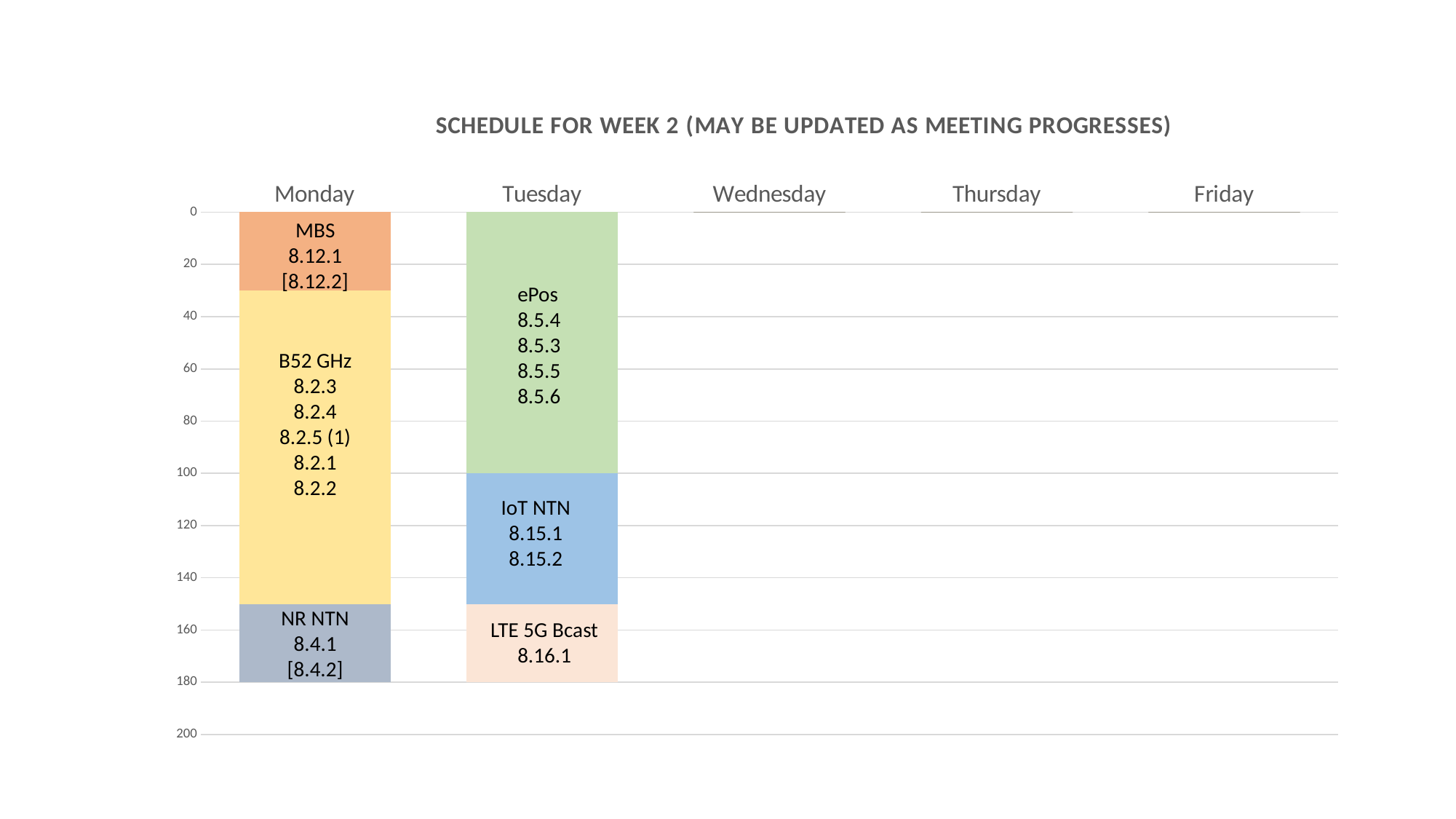
How many day categories are shown along the x axis? 5 How many segments make up the Monday bar? 3 Which segment is the largest in the Monday bar? B52 GHz How many segments make up the Tuesday bar? 3 Which segment is larger, ePos or IoT NTN? ePos Is the axis value where the ePos segment ends greater or less than 80? greater Which segment is the smallest in the Tuesday bar? LTE 5G Bcast Which segment is the largest in the Tuesday bar? ePos What kind of chart is shown on the slide? stacked bar chart Which days have no bar plotted? Wednesday, Thursday, Friday At which axis value does the Monday bar end? 180 What is the title of the chart? SCHEDULE FOR WEEK 2 (MAY BE UPDATED AS MEETING PROGRESSES)